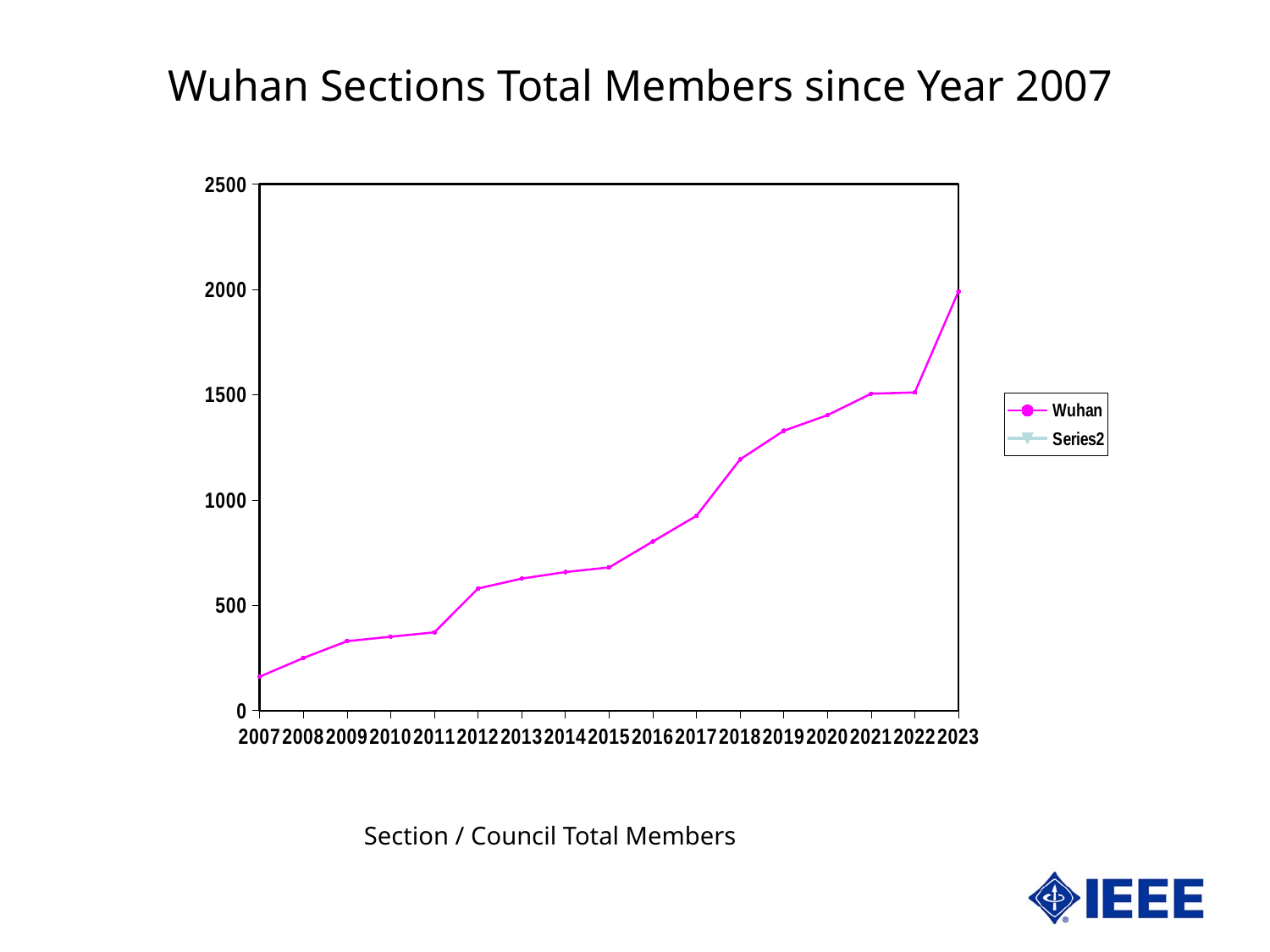
What is the title of the chart? Wuhan Sections Total Members since Year 2007 Is the value for Wuhan in 2007 greater or less than 500? less What kind of chart is shown on the slide? line chart How many years are plotted on the x axis? 17 Which year has the larger value for Wuhan, 2012 or 2018? 2018 Is the value for Wuhan in 2023 greater or less than 1500? greater Which year has the highest value for Wuhan? 2023 Do the Wuhan values generally rise or fall from 2007 to 2023? rise Which year has the lowest value for Wuhan? 2007 Is the value for Wuhan in 2018 greater or less than 1000? greater How many series does the legend list? 2